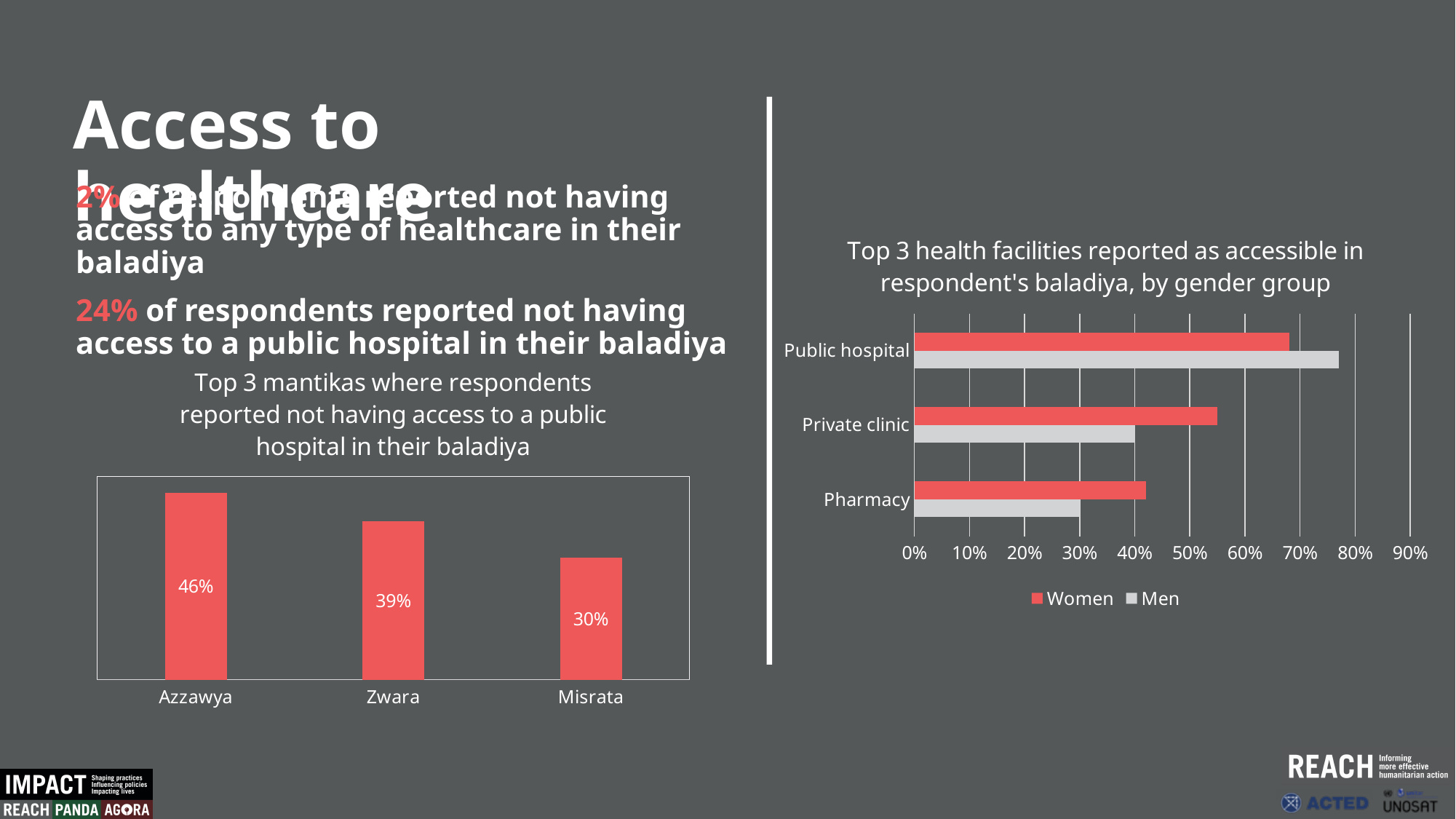
What kind of chart is the right chart (Top 3 health facilities reported as accessible, by gender group)? bar chart In the right chart (Top 3 health facilities reported as accessible, by gender group), how many series does the legend list? 2 In the left chart (Top 3 mantikas where respondents reported not having access to a public hospital), what is the value for Misrata? 30% In the left chart (Top 3 mantikas where respondents reported not having access to a public hospital), what is the value for Azzawya? 46% In the right chart (Top 3 health facilities reported as accessible, by gender group), which is larger for Private clinic: Women or Men? Women In the right chart (Top 3 health facilities reported as accessible, by gender group), which facility has the highest value for Women? Public hospital In the left chart (Top 3 mantikas where respondents reported not having access to a public hospital), how many mantikas are shown? 3 In the left chart (Top 3 mantikas where respondents reported not having access to a public hospital), which mantika has the highest value? Azzawya In the right chart (Top 3 health facilities reported as accessible, by gender group), is the value for Men at Public hospital greater or less than 70%? greater In the left chart (Top 3 mantikas where respondents reported not having access to a public hospital), what is the difference between Azzawya and Zwara? 7% In the left chart (Top 3 mantikas where respondents reported not having access to a public hospital), do the values rise or fall from left to right? fall In the right chart (Top 3 health facilities reported as accessible, by gender group), is the value for Women at Pharmacy greater or less than 50%? less